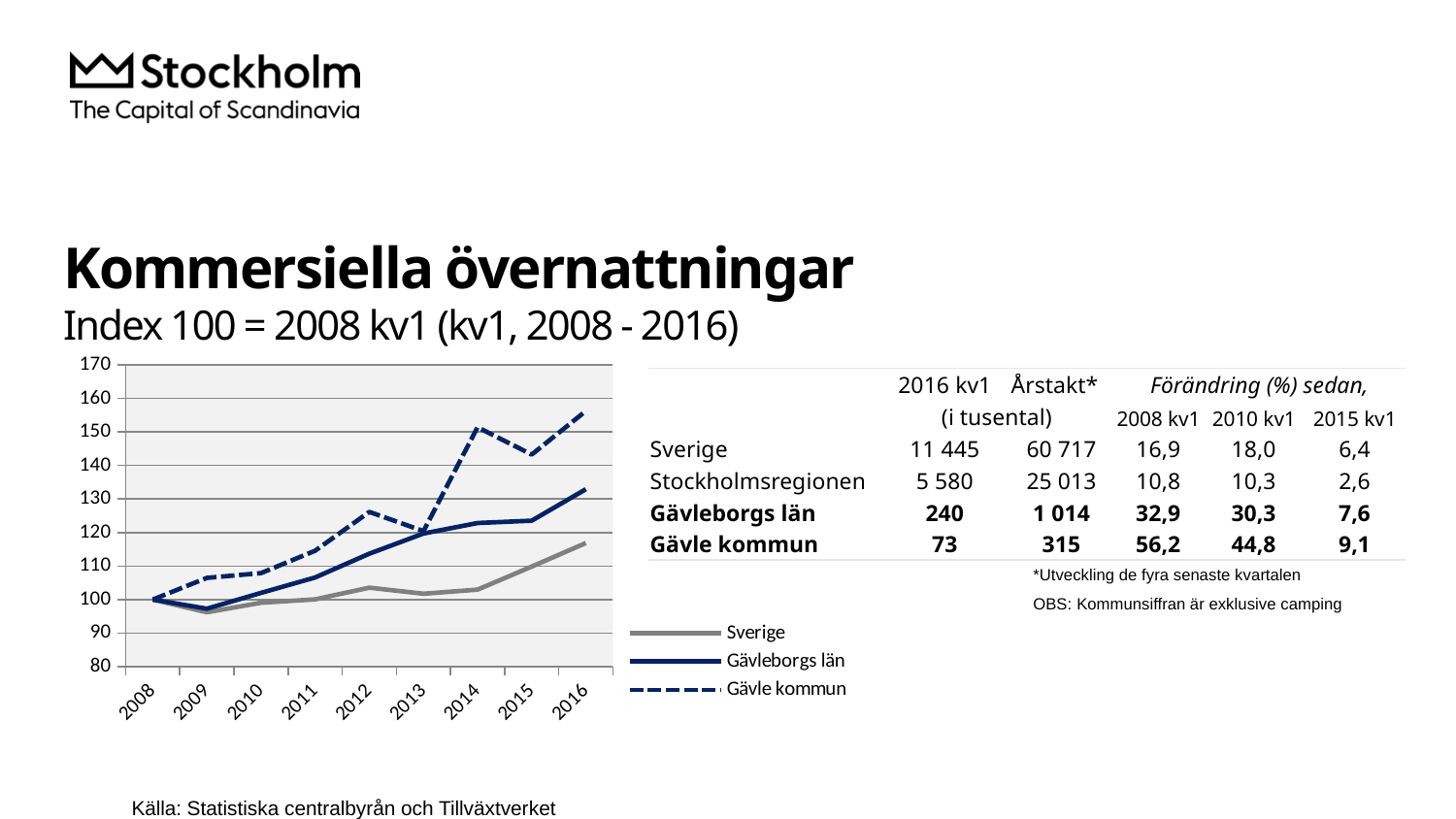
What kind of chart is shown on the slide? line chart Is the value for Sverige in 2016 greater or less than 120? less Does the Gävleborgs län line rise or fall from 2008 to 2016? rises Is the value for Gävle kommun in 2016 greater or less than 150? greater Which series has the lowest value in 2016? Sverige What is the index value for Sverige in 2008? 100 Which series has the highest value in 2016? Gävle kommun In 2016, which is larger: the value for Gävle kommun or the value for Sverige? Gävle kommun How many series does the chart's legend list? 3 Is the value for Gävleborgs län in 2016 greater or less than 120? greater How many years are shown along the x axis of the chart? 9